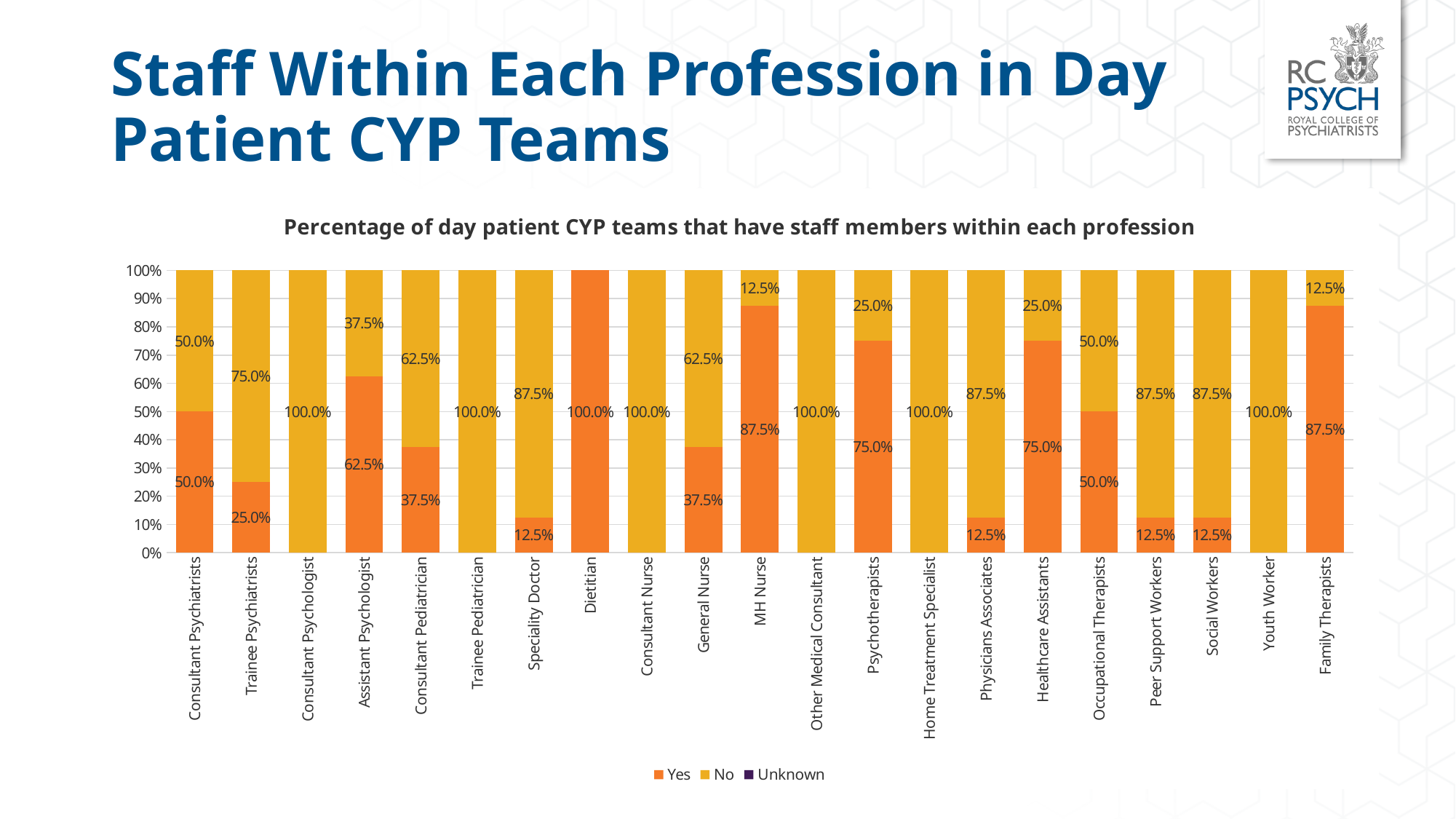
What is the "No" value for Trainee Psychiatrists? 75.0% How many series does the legend list? 3 How many professions are shown on the x axis? 21 What is the "Yes" value for MH Nurse? 87.5% What is the total of the stacked bar for Occupational Therapists? 100.0% What is the difference between the "Yes" values for Psychotherapists and Speciality Doctor? 62.5% What percentage of day patient CYP teams answered "Yes" for Assistant Psychologist? 62.5% Which profession has the highest "Yes" percentage? Dietitian What kind of chart is shown on the slide? Stacked bar chart Which series is shown in orange in the legend? Yes Which has a larger "Yes" value: Consultant Pediatrician or Family Therapists? Family Therapists What is the "No" value for Healthcare Assistants? 25.0%